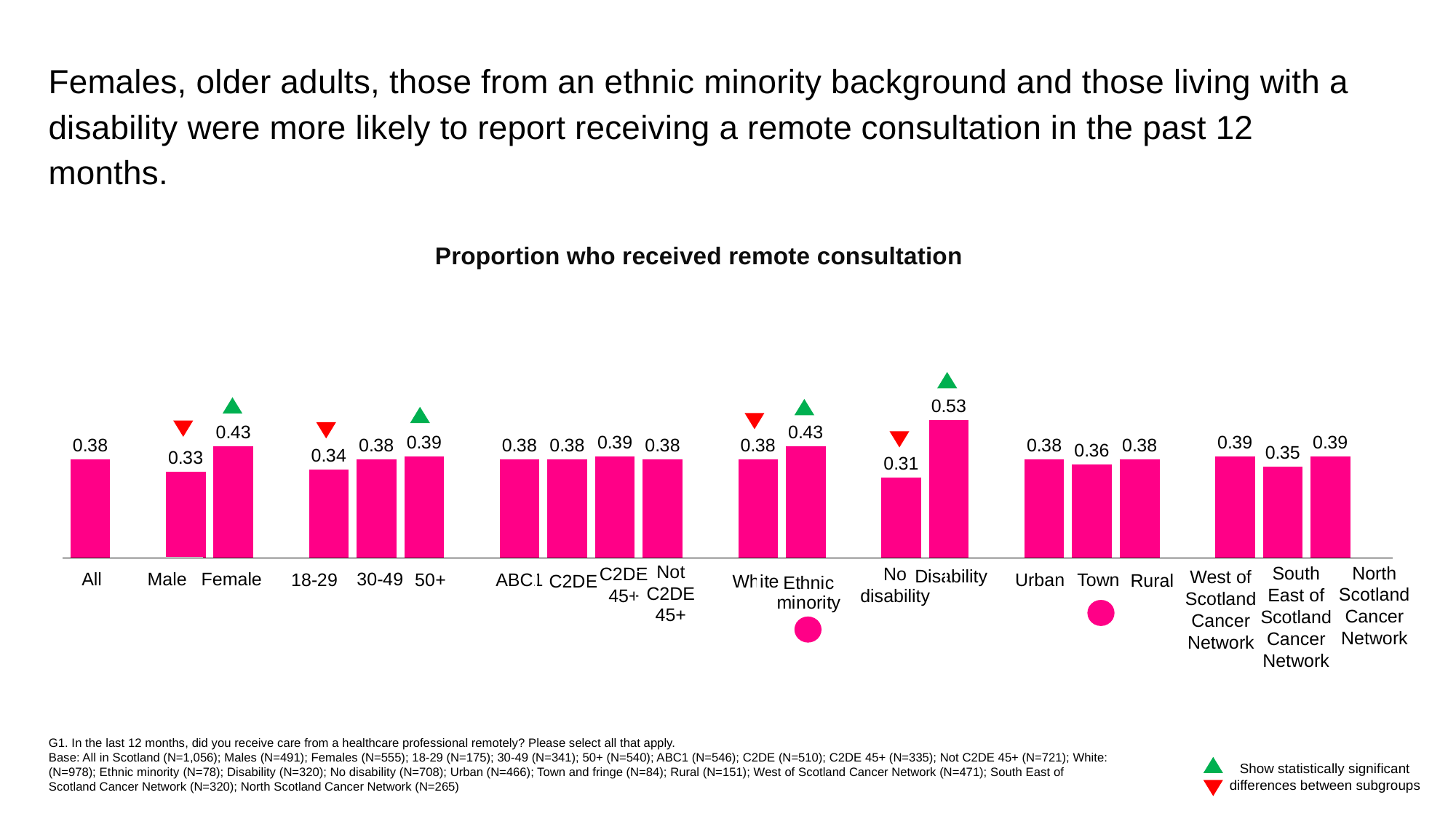
What is the value for Town? 0.36 What is the value for Disability? 0.53 Which category has the lowest value? No disability Which category has the highest value? Disability What kind of chart is shown on the slide? Bar chart How many bars are plotted in the chart? 20 What is the value for Female? 0.43 What is the title of the chart? Proportion who received remote consultation What is the difference between the values for Female and Male? 0.10 What is the difference between the values for Disability and No disability? 0.22 What is the value for South East of Scotland Cancer Network? 0.35 Which is larger, the value for Ethnic minority or the value for White? Ethnic minority